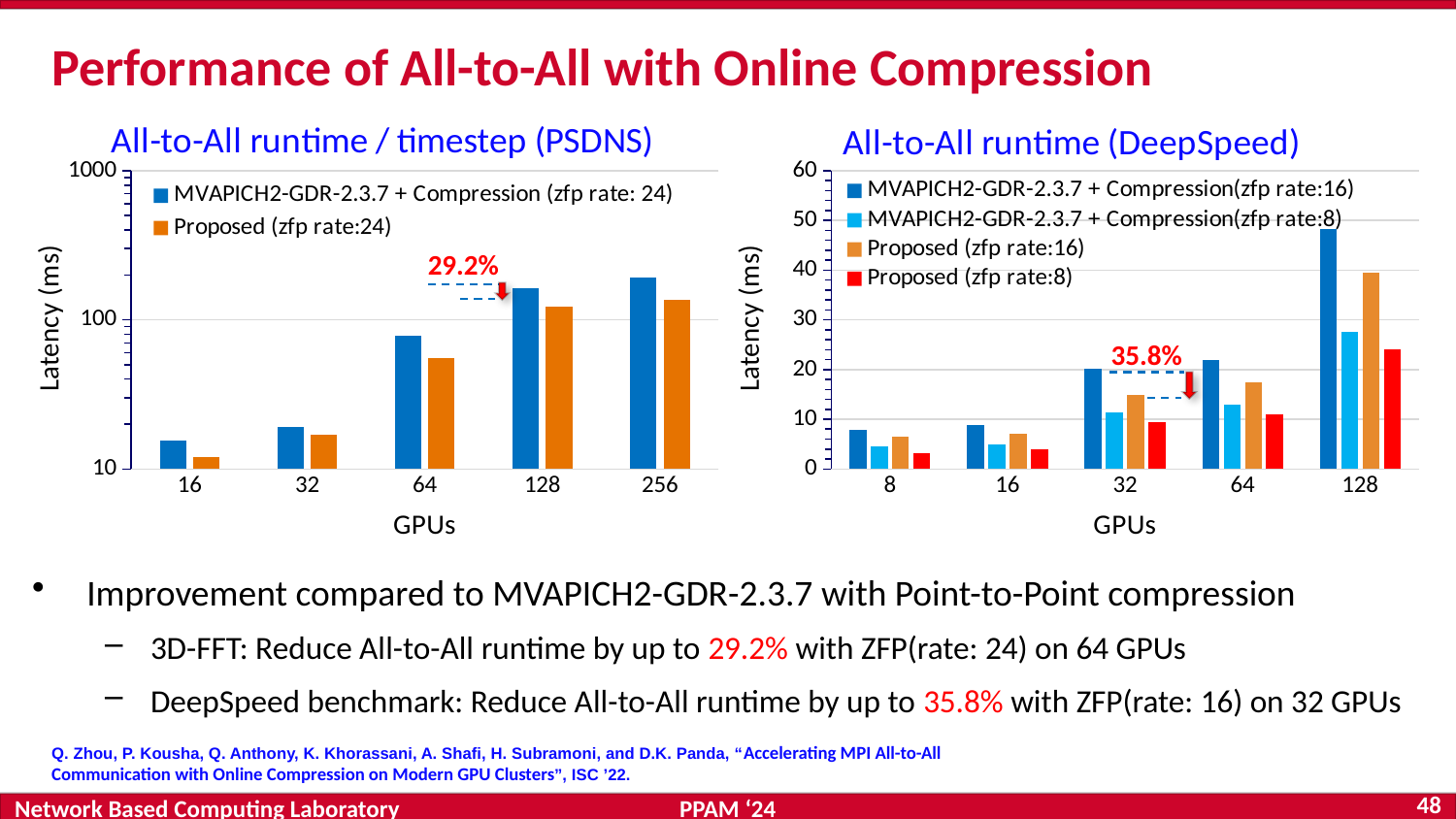
How many series does the legend of the 'All-to-All runtime (DeepSpeed)' chart list? 4 How many GPU counts are shown on the x axis of the 'All-to-All runtime / timestep (PSDNS)' chart? 5 In the 'All-to-All runtime (DeepSpeed)' chart, is the latency for 'MVAPICH2-GDR-2.3.7 + Compression(zfp rate:16)' at 128 GPUs greater or less than 40? greater What type of chart is the 'All-to-All runtime / timestep (PSDNS)' chart? bar chart In the 'All-to-All runtime (DeepSpeed)' chart, at which GPU count is the latency for 'MVAPICH2-GDR-2.3.7 + Compression(zfp rate:16)' highest? 128 In the 'All-to-All runtime / timestep (PSDNS)' chart, at which GPU count is the latency for 'Proposed (zfp rate:24)' highest? 256 In the 'All-to-All runtime / timestep (PSDNS)' chart, at which GPU count is the latency for 'MVAPICH2-GDR-2.3.7 + Compression (zfp rate: 24)' lowest? 16 In the 'All-to-All runtime (DeepSpeed)' chart, does the latency for 'Proposed (zfp rate:16)' rise or fall as the number of GPUs increases from 8 to 128? rise In the 'All-to-All runtime / timestep (PSDNS)' chart, is the latency for 'Proposed (zfp rate:24)' at 64 GPUs greater or less than 100? less In the 'All-to-All runtime / timestep (PSDNS)' chart, is the latency for 'MVAPICH2-GDR-2.3.7 + Compression (zfp rate: 24)' at 128 GPUs greater or less than 100? greater In the 'All-to-All runtime (DeepSpeed)' chart at 32 GPUs, which has the larger latency: 'MVAPICH2-GDR-2.3.7 + Compression(zfp rate:16)' or 'Proposed (zfp rate:16)'? MVAPICH2-GDR-2.3.7 + Compression(zfp rate:16)